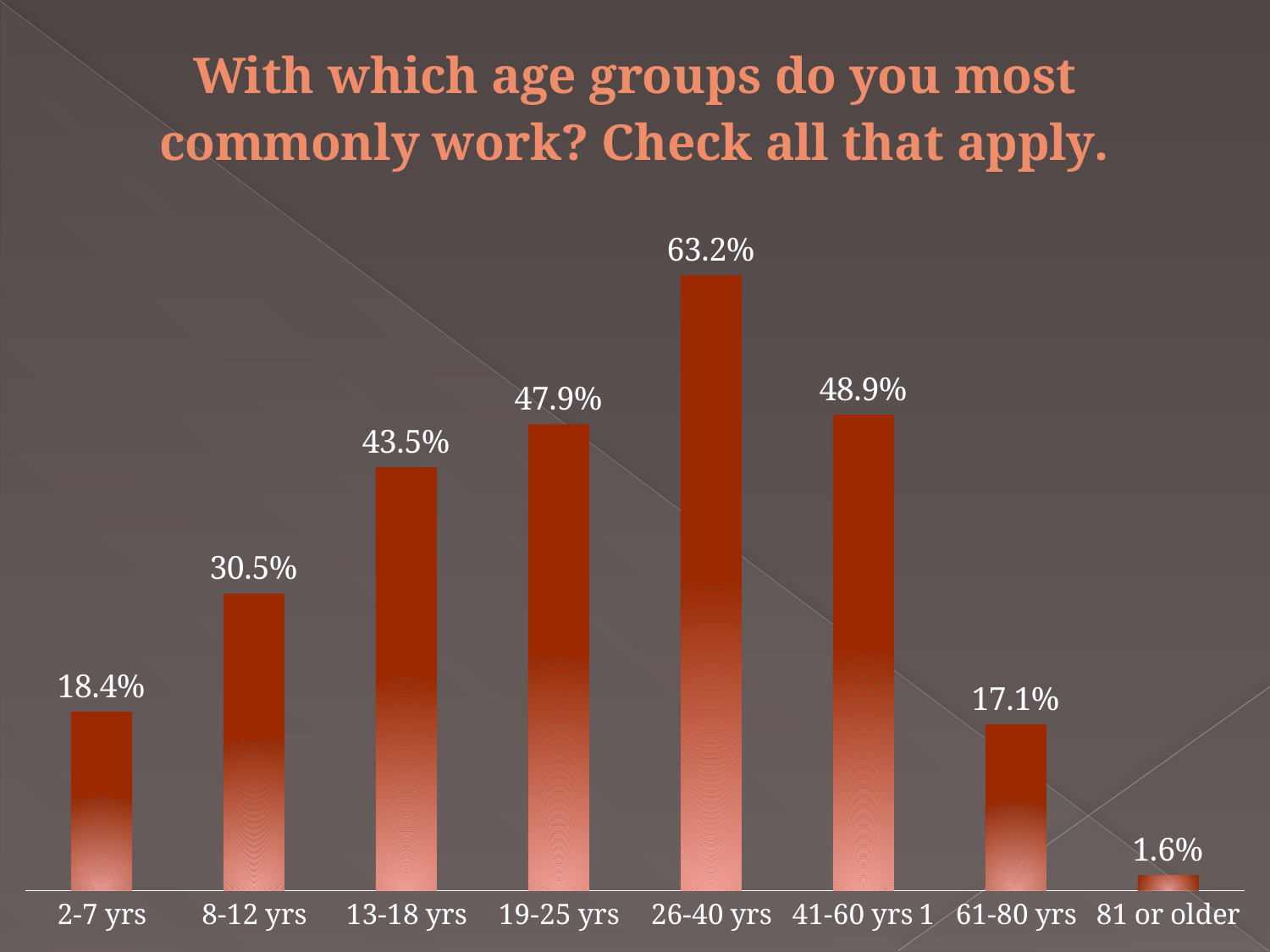
Which age group has the lowest value? 81 or older How many age group categories are shown in the chart? 8 What is the value for the 61-80 yrs age group? 17.1% Which is larger, the value for 2-7 yrs or the value for 61-80 yrs? 2-7 yrs Which age group has the highest value? 26-40 yrs What is the value for the 2-7 yrs age group? 18.4% Which is larger, the value for 19-25 yrs or the value for 13-18 yrs? 19-25 yrs What kind of chart is shown on the slide? Bar chart What is the title of the chart? With which age groups do you most commonly work? Check all that apply. What is the value for the 26-40 yrs age group? 63.2% What is the difference between the values for 8-12 yrs and 2-7 yrs? 12.1% What is the difference between the values for 26-40 yrs and 41-60 yrs? 14.3%